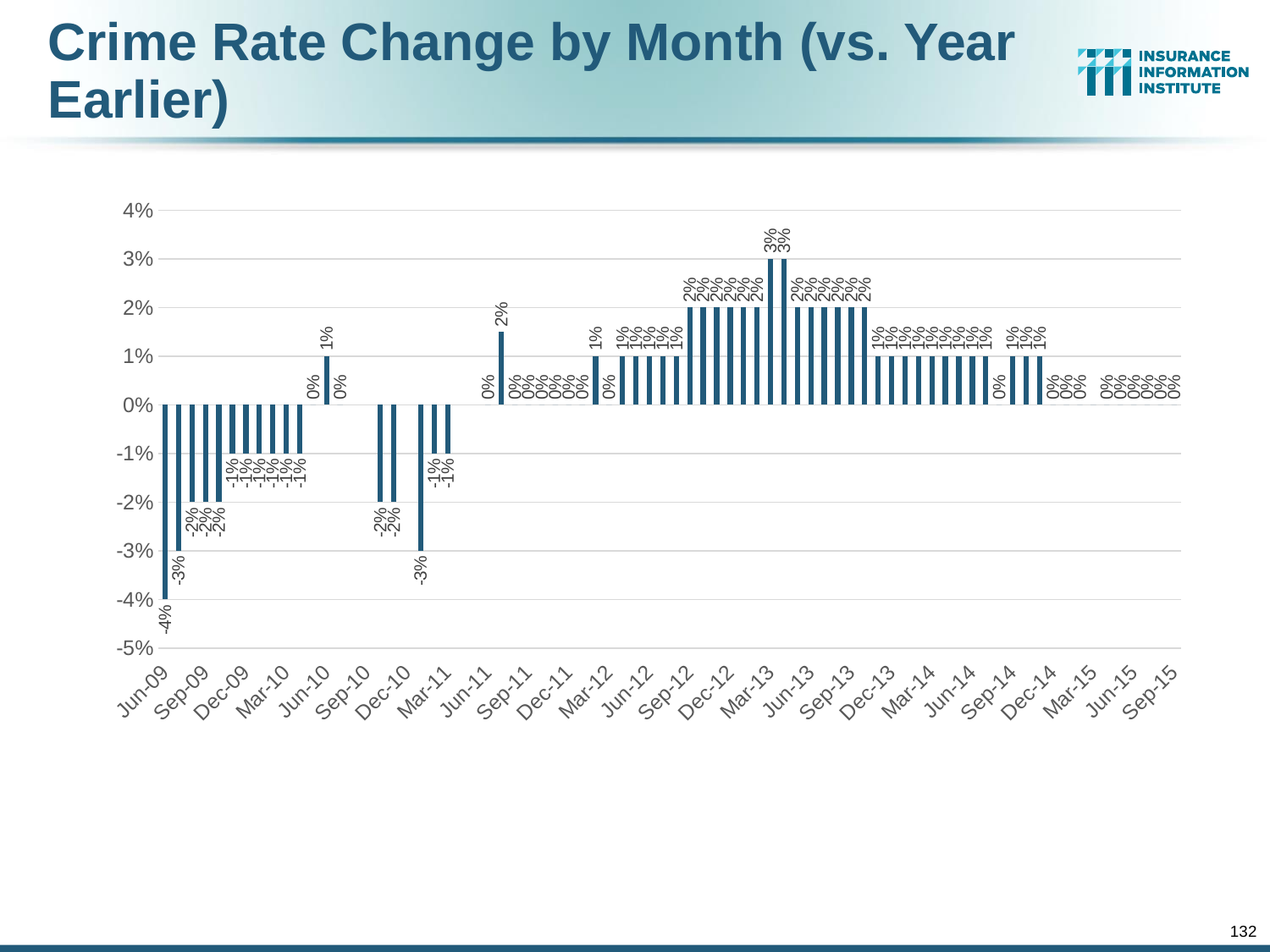
Which is larger, the value for Jun-09 or the value for Mar-13? Mar-13 What is the highest value shown on the chart? 3% Do the values rise or fall from Jun-09 to Mar-10? Rise What is the highest value labelled on the vertical axis? 4% What is the crime rate change shown for Jun-09? -4% What is the difference between the highest value (3%) and the lowest value (-4%) on the chart? 7 percentage points Which month has the lowest crime rate change on the chart? Jun-09 What is the title of the chart? Crime Rate Change by Month (vs. Year Earlier) What is the lowest value labelled on the vertical axis? -5% Is the value for Jun-09 greater or less than -3%? less What is the lowest value shown on the chart? -4% What type of chart is shown on the slide? Bar chart